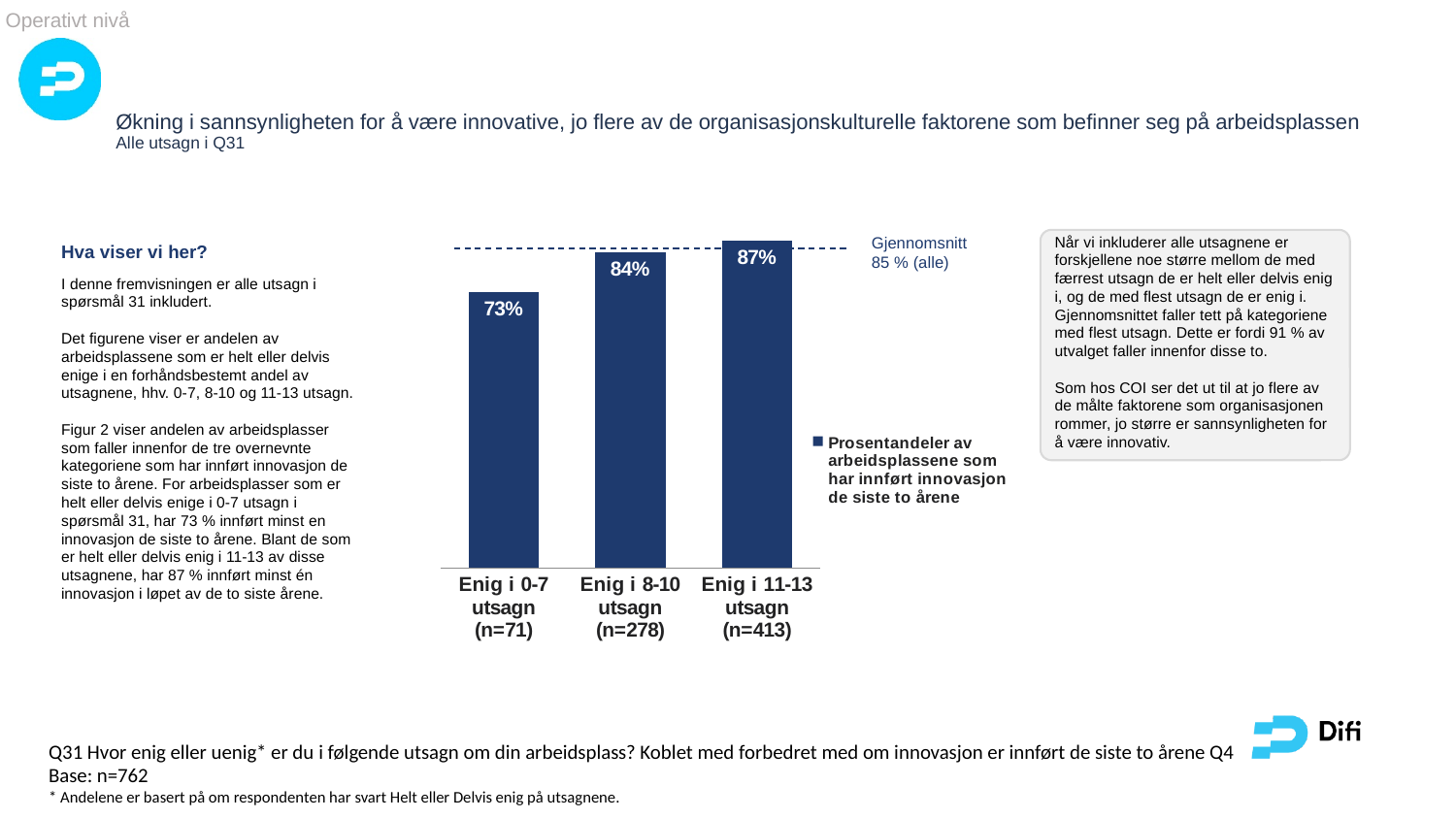
What is the value for 'Enig i 11-13 utsagn (n=413)'? 87% Which category has the highest value? Enig i 11-13 utsagn (n=413) What average value is indicated by the dashed line on the chart? 85 % (alle) What is the value for 'Enig i 8-10 utsagn (n=278)'? 84% What kind of chart is shown on the slide? Bar chart What is the difference between the values for 'Enig i 8-10 utsagn' and 'Enig i 0-7 utsagn'? 11 percentage points Which category has the lowest value? Enig i 0-7 utsagn (n=71) What is the value for 'Enig i 0-7 utsagn (n=71)'? 73% How many categories are shown in the chart? 3 Which is larger, the value for 'Enig i 8-10 utsagn' or 'Enig i 11-13 utsagn'? Enig i 11-13 utsagn Do the values rise or fall from left to right across the categories? Rise What is the difference between the values for 'Enig i 11-13 utsagn' and 'Enig i 0-7 utsagn'? 14 percentage points